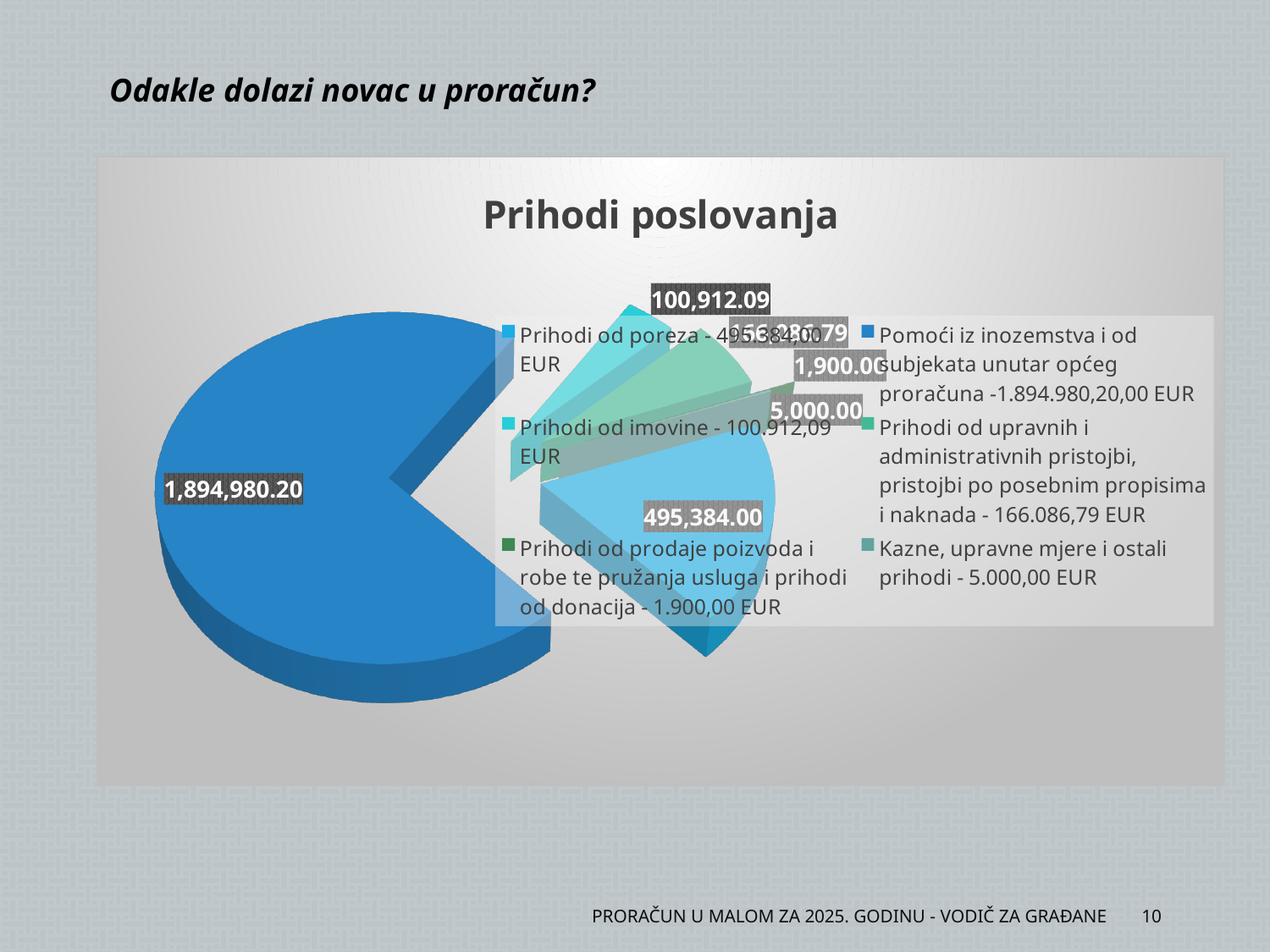
What kind of chart is shown on the slide? pie chart What is the difference between the values for Prihodi od poreza and Prihodi od imovine? 394,471.91 What value does the data label show for Prihodi od imovine? 100,912.09 How many slices does the pie chart have? 6 Which is larger, the value for Prihodi od poreza or the value for Prihodi od imovine? Prihodi od poreza What value does the data label show for Prihodi od poreza? 495,384.00 Which category has the largest slice of the pie chart? Pomoći iz inozemstva i od subjekata unutar općeg proračuna What value does the data label show for Kazne, upravne mjere i ostali prihodi? 5,000.00 What is the difference between the values for Kazne, upravne mjere i ostali prihodi and Prihodi od prodaje poizvoda i robe te pružanja usluga i prihodi od donacija? 3,100.00 What is the value shown for the largest slice of the pie chart? 1,894,980.20 What is the title of the chart? Prihodi poslovanja Which category has the smallest slice of the pie chart? Prihodi od prodaje poizvoda i robe te pružanja usluga i prihodi od donacija